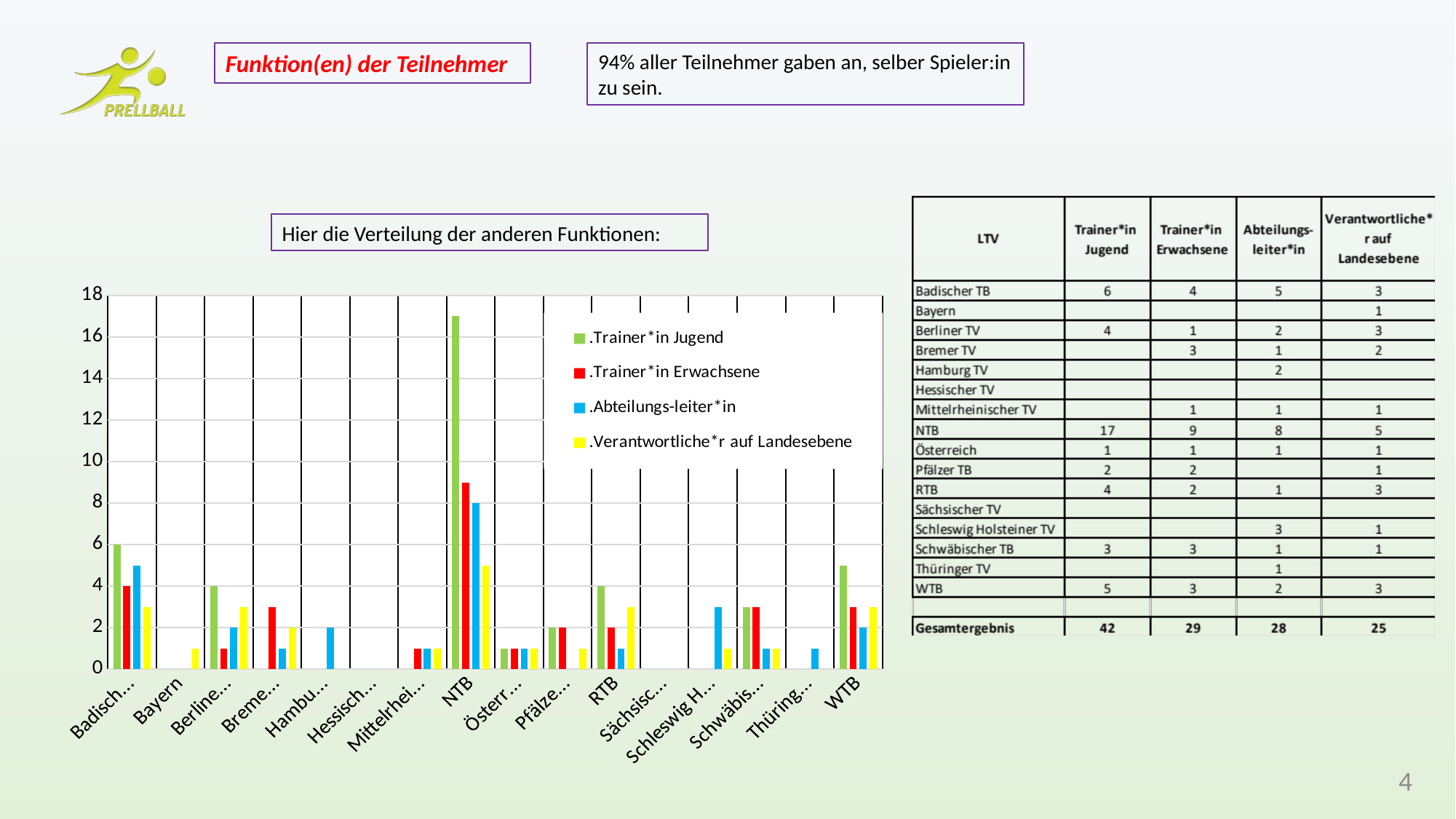
What kind of chart is shown on the slide? bar chart Which category has the highest value for Trainer*in Erwachsene? NTB What colour represents Verantwortliche*r auf Landesebene in the chart? yellow What is the value for Abteilungs-leiter*in at NTB? 8 What is the difference between the Trainer*in Jugend and Trainer*in Erwachsene values at NTB? 8 How many categories are shown along the x axis of the chart? 16 Is the value for Trainer*in Jugend at NTB greater or less than 16? greater Which is larger: the Trainer*in Jugend value for Badischer TB or for WTB? Badischer TB What is the value for Trainer*in Jugend at NTB? 17 Which category has the highest value for Trainer*in Jugend? NTB What is the value for Trainer*in Jugend at Badischer TB? 6 How many series does the chart legend list? 4